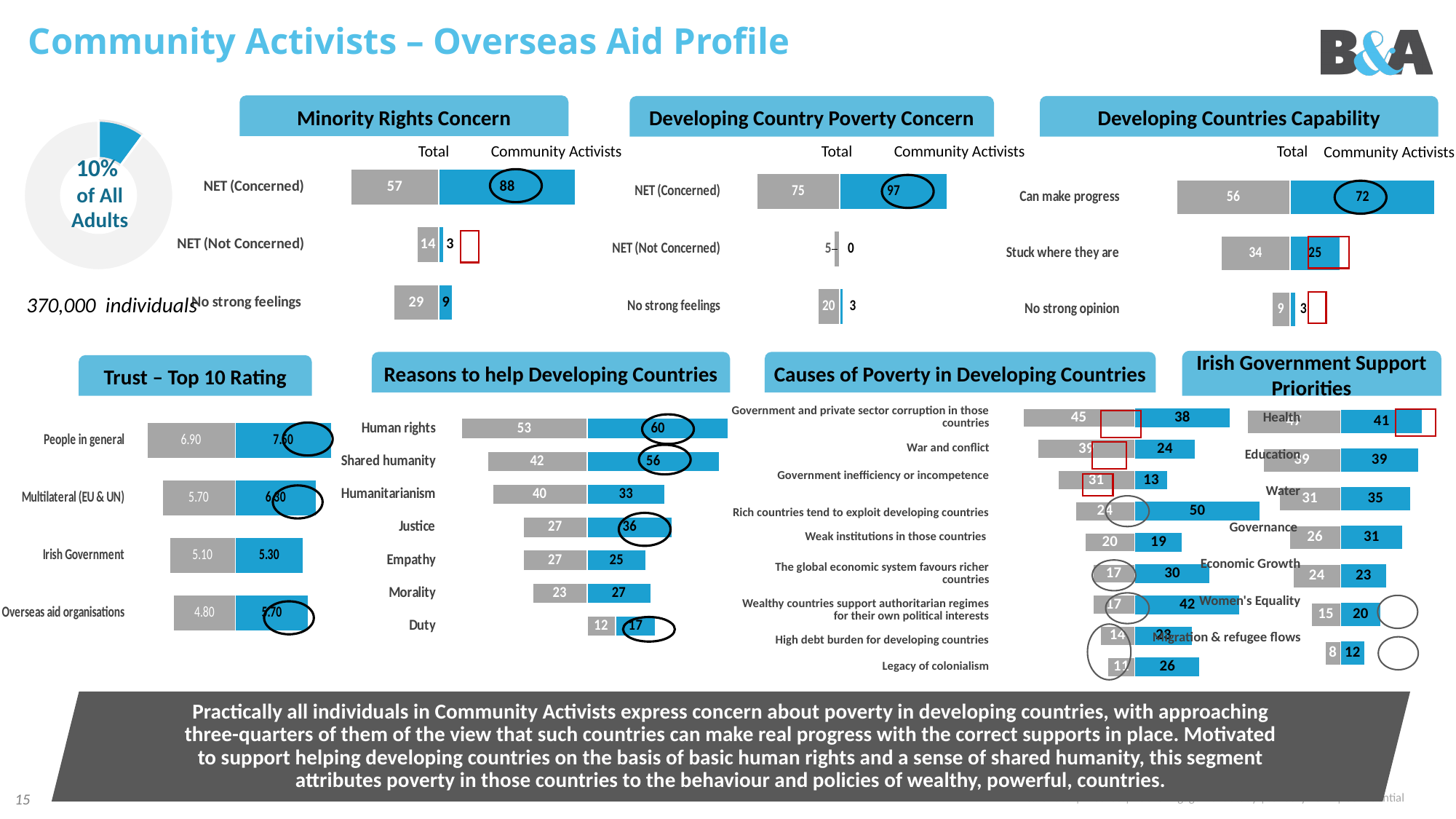
What type of chart is used for Reasons to help Developing Countries? bar chart In the Minority Rights Concern chart, what is the Community Activists value for NET (Concerned)? 88 In the Reasons to help Developing Countries chart, how many reasons are listed? 7 In the Developing Countries Capability chart, what is the difference between the Community Activists and Total values for Can make progress? 16 What share of all adults does the donut chart show for Community Activists? 10% In the Irish Government Support Priorities chart, is the Community Activists value for Water larger or smaller than the Total value? larger In the Reasons to help Developing Countries chart, which reason has the highest Community Activists value? Human rights In the Causes of Poverty in Developing Countries chart, which cause has the lowest Total value? Legacy of colonialism In the Trust – Top 10 Rating chart, what is the Community Activists value for Irish Government? 5.30 In the Irish Government Support Priorities chart, what is the Community Activists value for Education? 39 In the Developing Country Poverty Concern chart, what is the Total value for NET (Concerned)? 75 In the Causes of Poverty in Developing Countries chart, what is the Community Activists value for Rich countries tend to exploit developing countries? 50